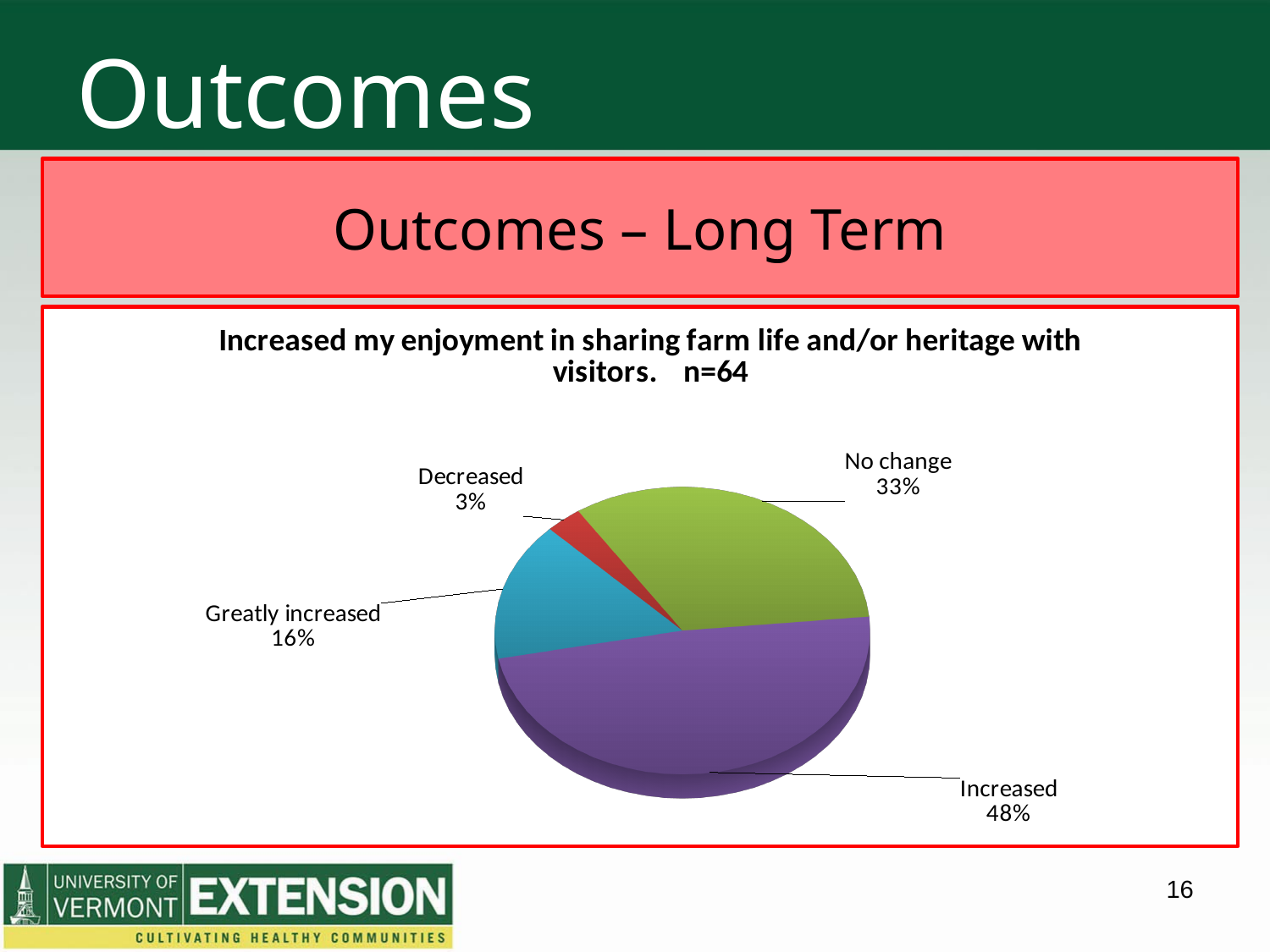
What type of chart is shown on the slide? Pie chart What percentage of respondents answered "Increased"? 48% Which response category has the largest share of the pie? Increased How many response categories are shown in the pie chart? 4 Which is larger, the share for "Greatly increased" or the share for "No change"? No change What is the difference in percentage points between "Increased" and "No change"? 15 What percentage of respondents answered "Decreased"? 3% Which response category has the smallest share of the pie? Decreased What percentage of respondents answered "Greatly increased"? 16% What is the sample size (n) stated in the chart title? n=64 What percentage of respondents answered "No change"? 33% What colour is the slice for "Increased"? Purple